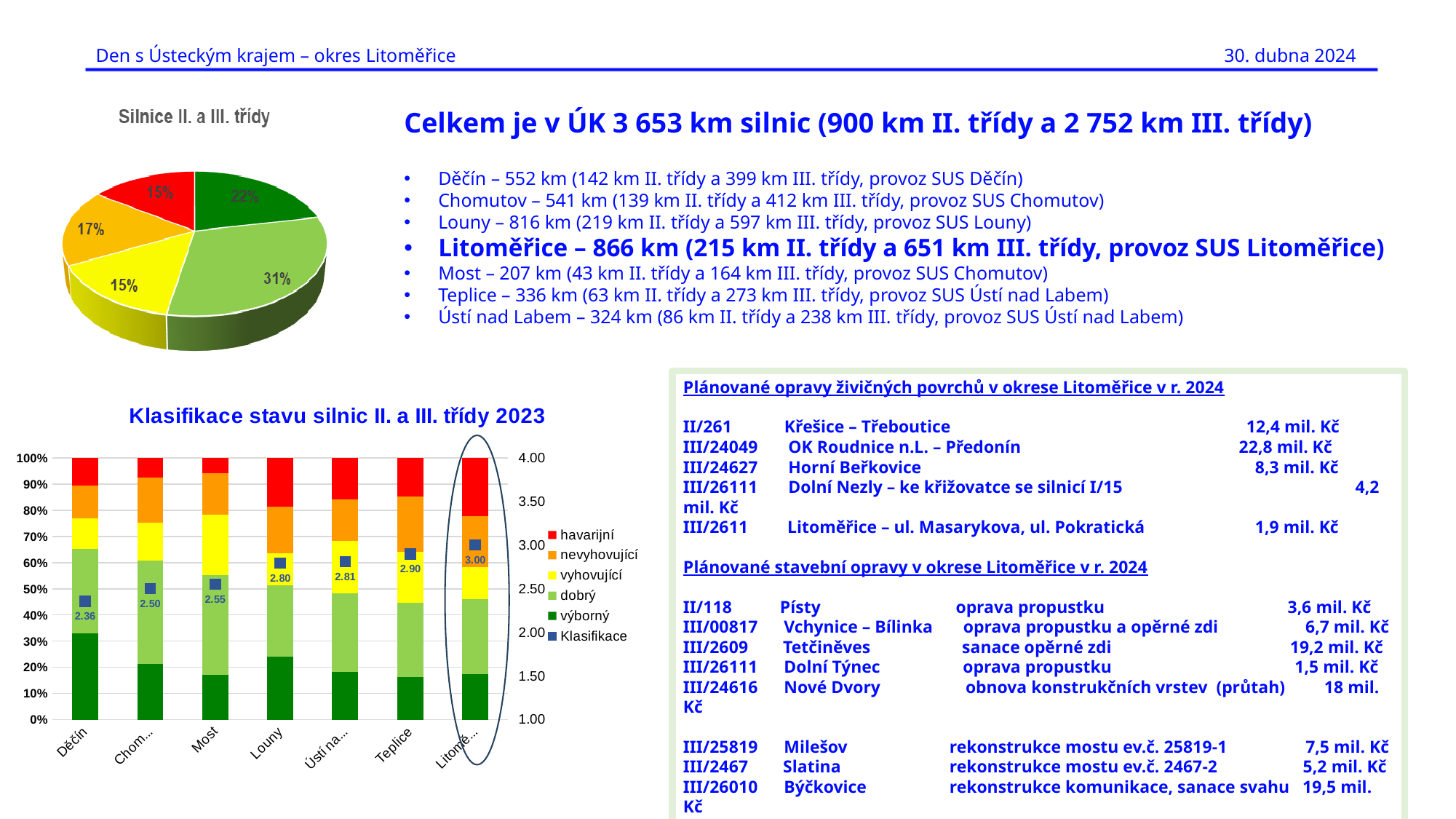
In the 'Klasifikace stavu silnic II. a III. třídy 2023' chart, what is the difference between the Klasifikace values of Teplice and Most? 0.35 How many series does the legend of the 'Klasifikace stavu silnic II. a III. třídy 2023' chart list? 6 How many slices does the 'Silnice II. a III. třídy' pie chart have? 5 In the 'Klasifikace stavu silnic II. a III. třídy 2023' chart, which district has the lowest Klasifikace value? Děčín In the 'Klasifikace stavu silnic II. a III. třídy 2023' chart, what is the Klasifikace value for Louny? 2.80 In the 'Klasifikace stavu silnic II. a III. třídy 2023' chart, do the Klasifikace values rise or fall from left to right? rise In the 'Klasifikace stavu silnic II. a III. třídy 2023' chart, what is the Klasifikace value for the rightmost bar (Litoměřice)? 3.00 What kind of chart is the 'Silnice II. a III. třídy' chart? pie chart In the 'Silnice II. a III. třídy' pie chart, what is the share of the largest slice? 31% In the 'Klasifikace stavu silnic II. a III. třídy 2023' chart, which has the higher Klasifikace value, Teplice or Most? Teplice In the 'Klasifikace stavu silnic II. a III. třídy 2023' chart, what is the Klasifikace value for Děčín? 2.36 What kind of chart is 'Klasifikace stavu silnic II. a III. třídy 2023'? combination chart: a 100% stacked bar chart with a Klasifikace marker (line) series